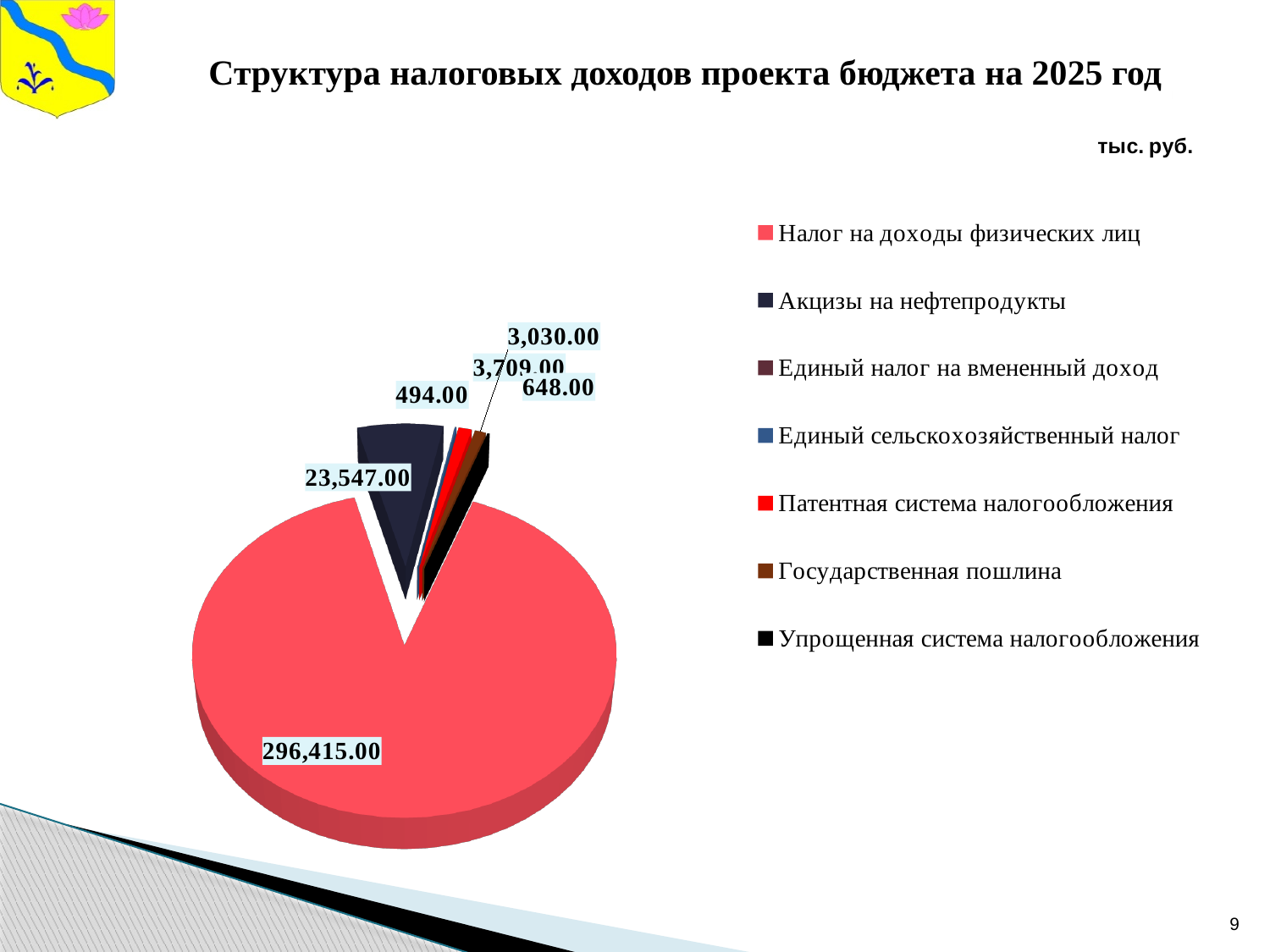
What unit is indicated for the values on the chart? тыс. руб. What is the smallest data label printed on the pie chart? 494.00 Which category has the largest slice of the pie? Налог на доходы физических лиц What kind of chart is shown on the slide? pie chart What is the title of the chart on the slide? Структура налоговых доходов проекта бюджета на 2025 год What is the difference between the values for Налог на доходы физических лиц and Акцизы на нефтепродукты? 272,868.00 How many entries does the chart legend list? 7 Which is larger: the value for Налог на доходы физических лиц or the value for Акцизы на нефтепродукты? Налог на доходы физических лиц What is the value shown for Акцизы на нефтепродукты? 23,547.00 What is the value shown for Налог на доходы физических лиц? 296,415.00 Is the value for Акцизы на нефтепродукты greater or less than 20,000? greater